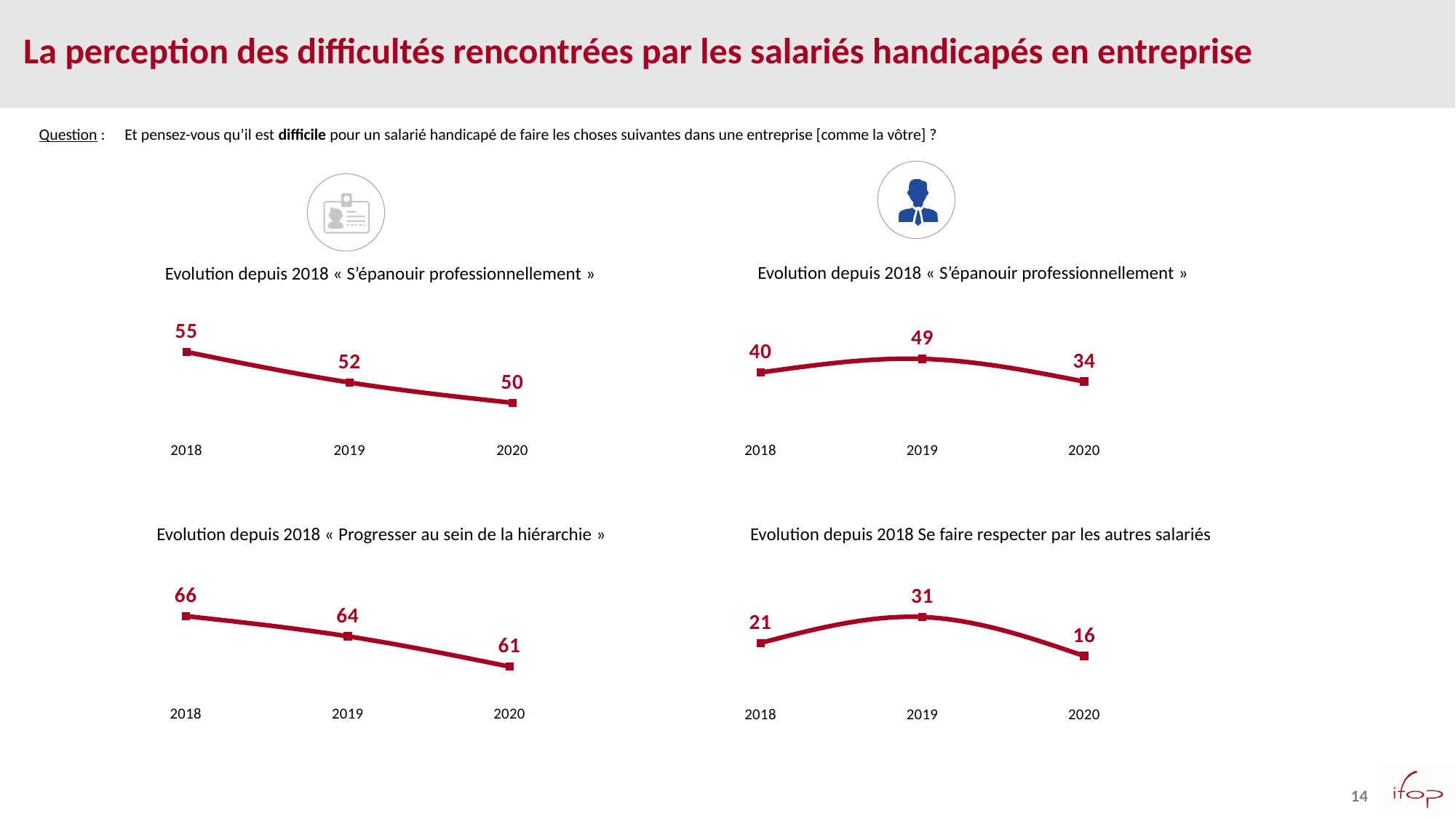
In the bottom-left chart « Progresser au sein de la hiérarchie », which is larger, the value for 2018 or the value for 2019? 2018 In the top-right chart, what is the value for 2019? 49 In the bottom-right chart « Se faire respecter par les autres salariés », which year has the highest value? 2019 In the top-left chart, what is the difference between the 2018 and 2020 values? 5 What type of chart is the top-right chart? line chart In the bottom-right chart « Se faire respecter par les autres salariés », what is the difference between the 2019 and 2020 values? 15 In the bottom-left chart « Progresser au sein de la hiérarchie », what is the value for 2020? 61 In the bottom-right chart « Se faire respecter par les autres salariés », what is the value for 2018? 21 How many data points are plotted in the bottom-left chart « Progresser au sein de la hiérarchie »? 3 In the top-right chart, which year has the lowest value? 2020 In the top-left chart, do the values rise or fall from 2018 to 2020? fall In the top-left chart, what is the value for 2018? 55